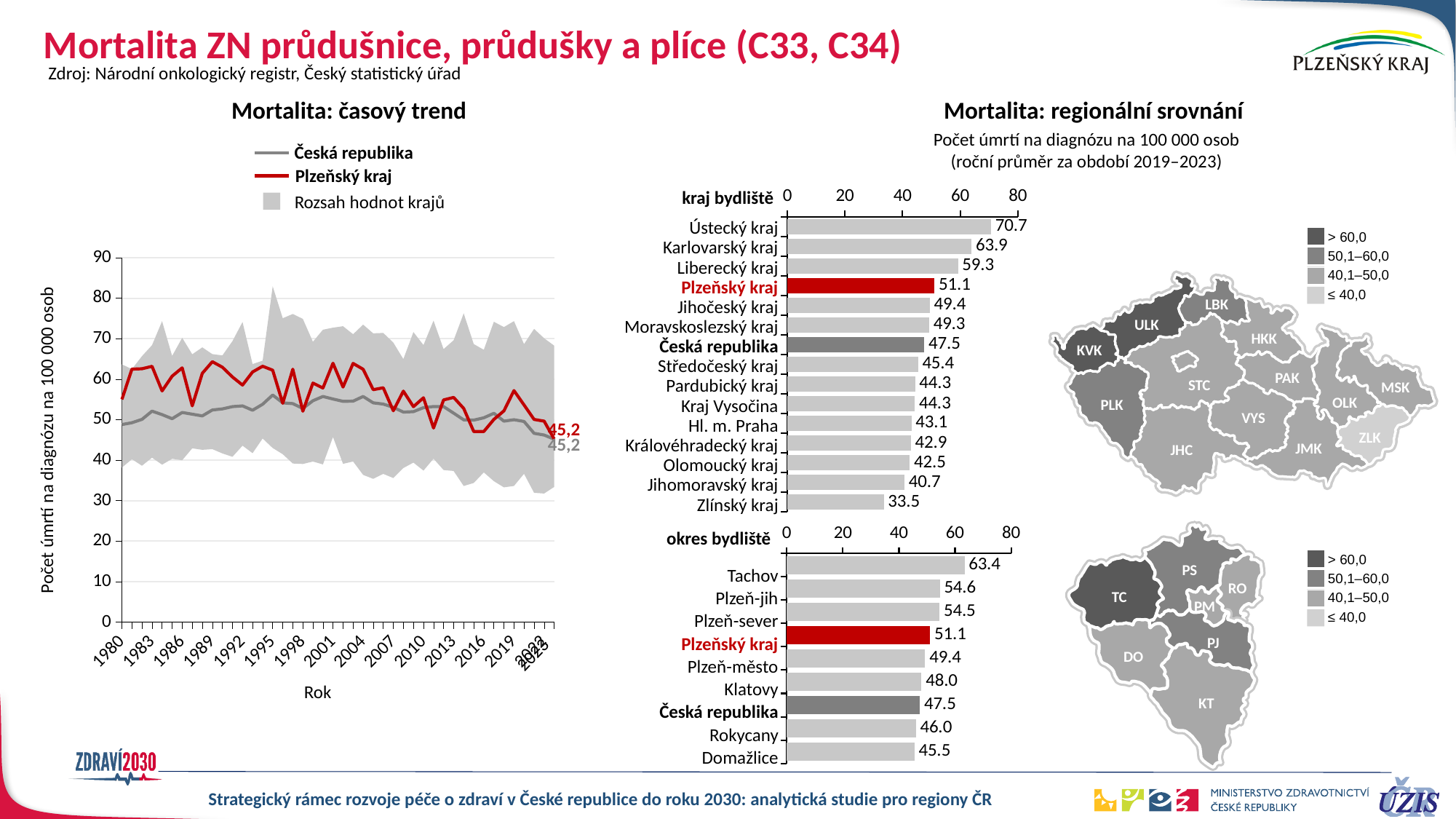
In the 'Mortalita: časový trend' chart, what is the value for Plzeňský kraj at the last year shown? 45,2 In the 'Mortalita: regionální srovnání' chart by kraj bydliště, what is the difference between Plzeňský kraj and Česká republika? 3.6 In the 'Mortalita: regionální srovnání' chart by okres bydliště, which district has the lowest value? Domažlice In the 'Mortalita: regionální srovnání' chart by okres bydliště, what is the difference between Plzeň-jih and Rokycany? 8.6 In the 'Mortalita: regionální srovnání' chart by kraj bydliště, which is larger: Karlovarský kraj or Liberecký kraj? Karlovarský kraj What kind of chart is 'Mortalita: regionální srovnání' by kraj bydliště? bar chart In the 'Mortalita: regionální srovnání' chart by kraj bydliště, how many bars are shown? 15 In the 'Mortalita: regionální srovnání' chart by okres bydliště, what is the value for Klatovy? 48.0 In the 'Mortalita: regionální srovnání' chart by kraj bydliště, what is the value for Ústecký kraj? 70.7 In the 'Mortalita: časový trend' chart, how many entries does the legend list? 3 In the 'Mortalita: regionální srovnání' chart by kraj bydliště, which region has the lowest value? Zlínský kraj In the 'Mortalita: regionální srovnání' chart by okres bydliště, what is the value for Tachov? 63.4